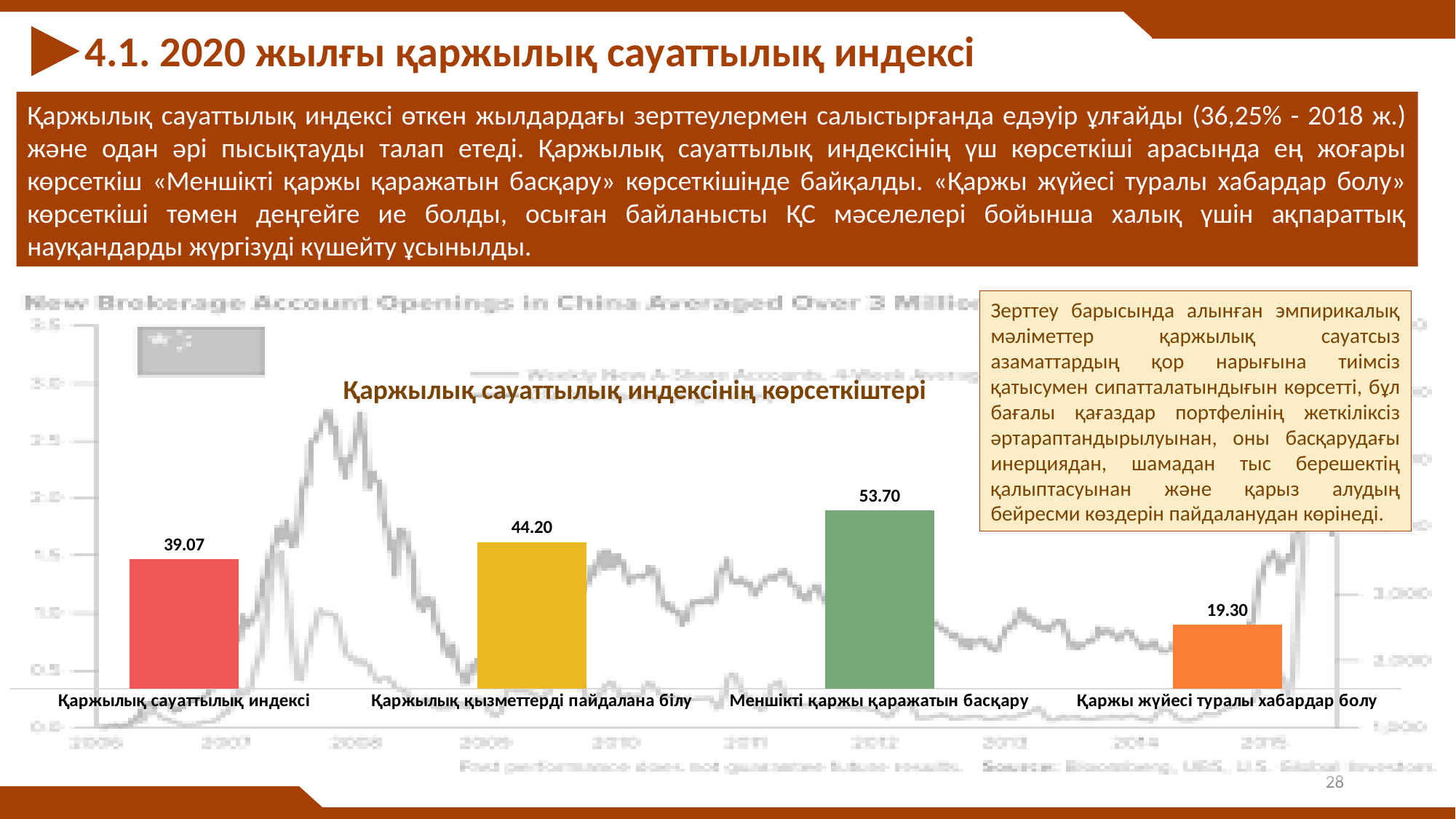
Which category has the highest value? Меншікті қаржы қаражатын басқару Which is larger: the value for Қаржылық қызметтерді пайдалана білу or the value for Қаржылық сауаттылық индексі? Қаржылық қызметтерді пайдалана білу Which category has the lowest value? Қаржы жүйесі туралы хабардар болу What is the difference between the values for Меншікті қаржы қаражатын басқару and Қаржы жүйесі туралы хабардар болу? 34.40 What is the value for Қаржылық қызметтерді пайдалана білу? 44.20 What is the value for Қаржы жүйесі туралы хабардар болу? 19.30 What is the difference between the values for Қаржылық қызметтерді пайдалана білу and Қаржылық сауаттылық индексі? 5.13 What kind of chart is used to show the financial literacy index indicators? Bar chart How many categories are shown in the bar chart? 4 What is the value for Қаржылық сауаттылық индексі? 39.07 What is the title of the bar chart? Қаржылық сауаттылық индексінің көрсеткіштері What is the value for Меншікті қаржы қаражатын басқару? 53.70